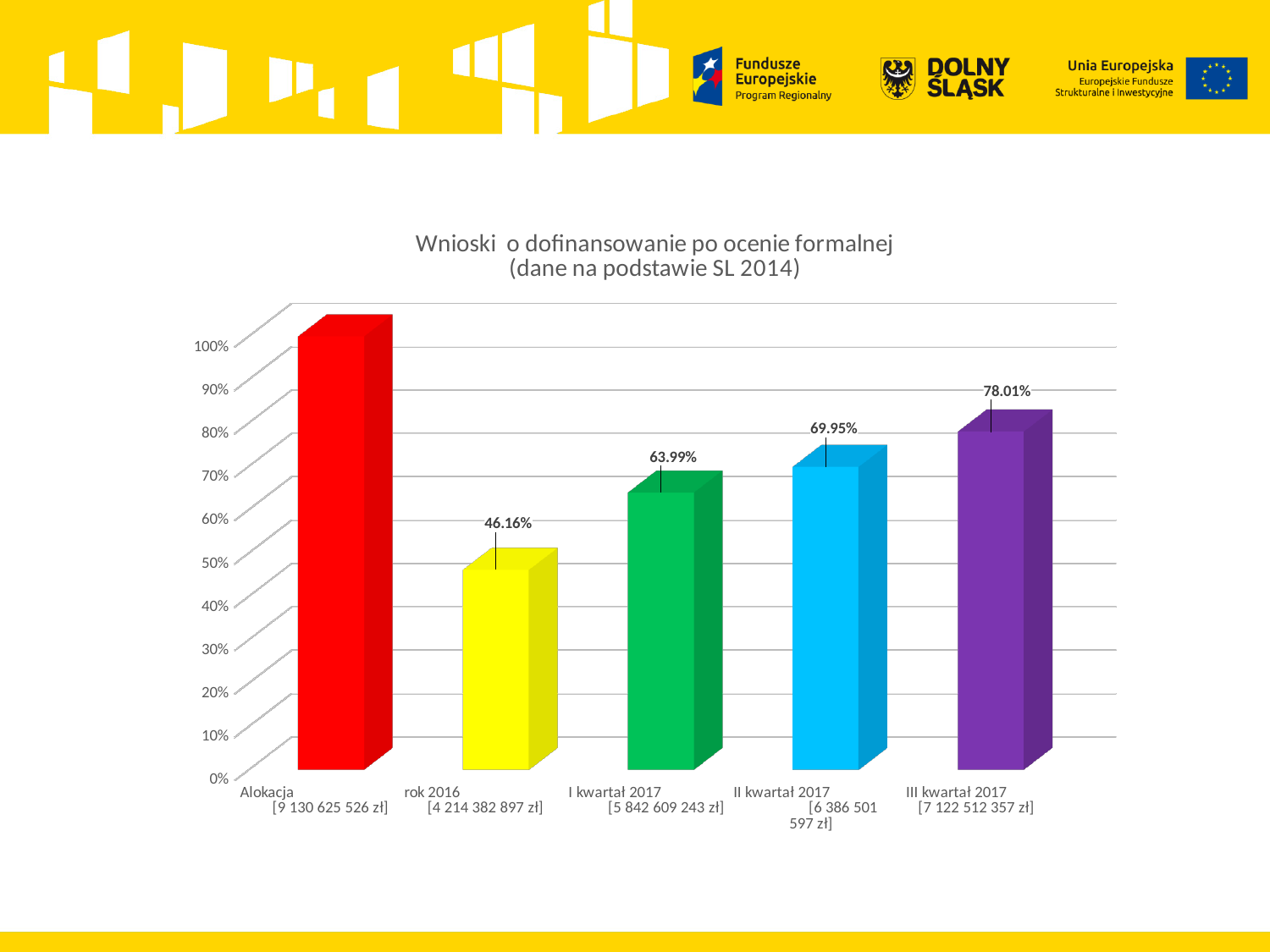
Is the value for Alokacja greater or less than 90%? greater What is the value shown for rok 2016? 46.16% Do the values rise or fall from rok 2016 to III kwartał 2017? rise Which category has the lowest value? rok 2016 What is the value shown for I kwartał 2017? 63.99% What is the value shown for II kwartał 2017? 69.95% What is the value shown for III kwartał 2017? 78.01% What is the difference between the values for III kwartał 2017 and II kwartał 2017? 8.06% How many categories are shown on the x axis? 5 Which category has the highest value? Alokacja What is the difference between the values for I kwartał 2017 and rok 2016? 17.83% Which is larger, the value for II kwartał 2017 or the value for I kwartał 2017? II kwartał 2017